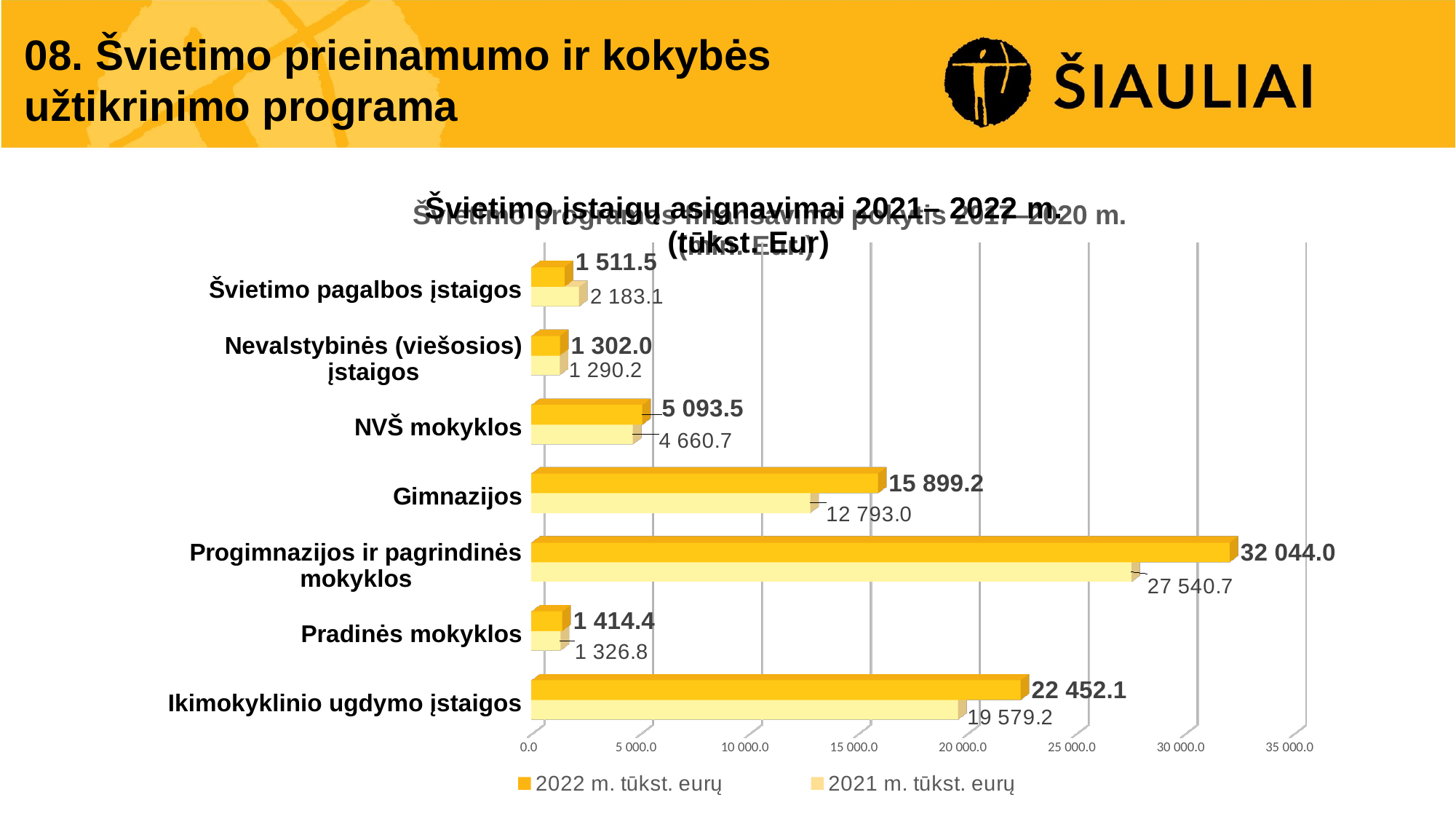
What is the 2022 m. tūkst. eurų value for Gimnazijos? 15 899.2 For Švietimo pagalbos įstaigos, which is larger: the 2022 value or the 2021 value? 2021 m. tūkst. eurų Which category has the lowest 2022 m. tūkst. eurų value? Nevalstybinės (viešosios) įstaigos Is the 2021 m. tūkst. eurų value for Gimnazijos greater or less than 15 000.0? less What is the 2022 m. tūkst. eurų value for NVŠ mokyklos? 5 093.5 Which category has the highest 2022 m. tūkst. eurų value? Progimnazijos ir pagrindinės mokyklos How many categories are shown on the chart? 7 What type of chart is shown on the slide? bar chart Which colour represents the 2021 m. tūkst. eurų series? light yellow What is the difference between the 2022 and 2021 values for Progimnazijos ir pagrindinės mokyklos? 4 503.3 What is the 2021 m. tūkst. eurų value for Ikimokyklinio ugdymo įstaigos? 19 579.2 How many series does the legend list? 2